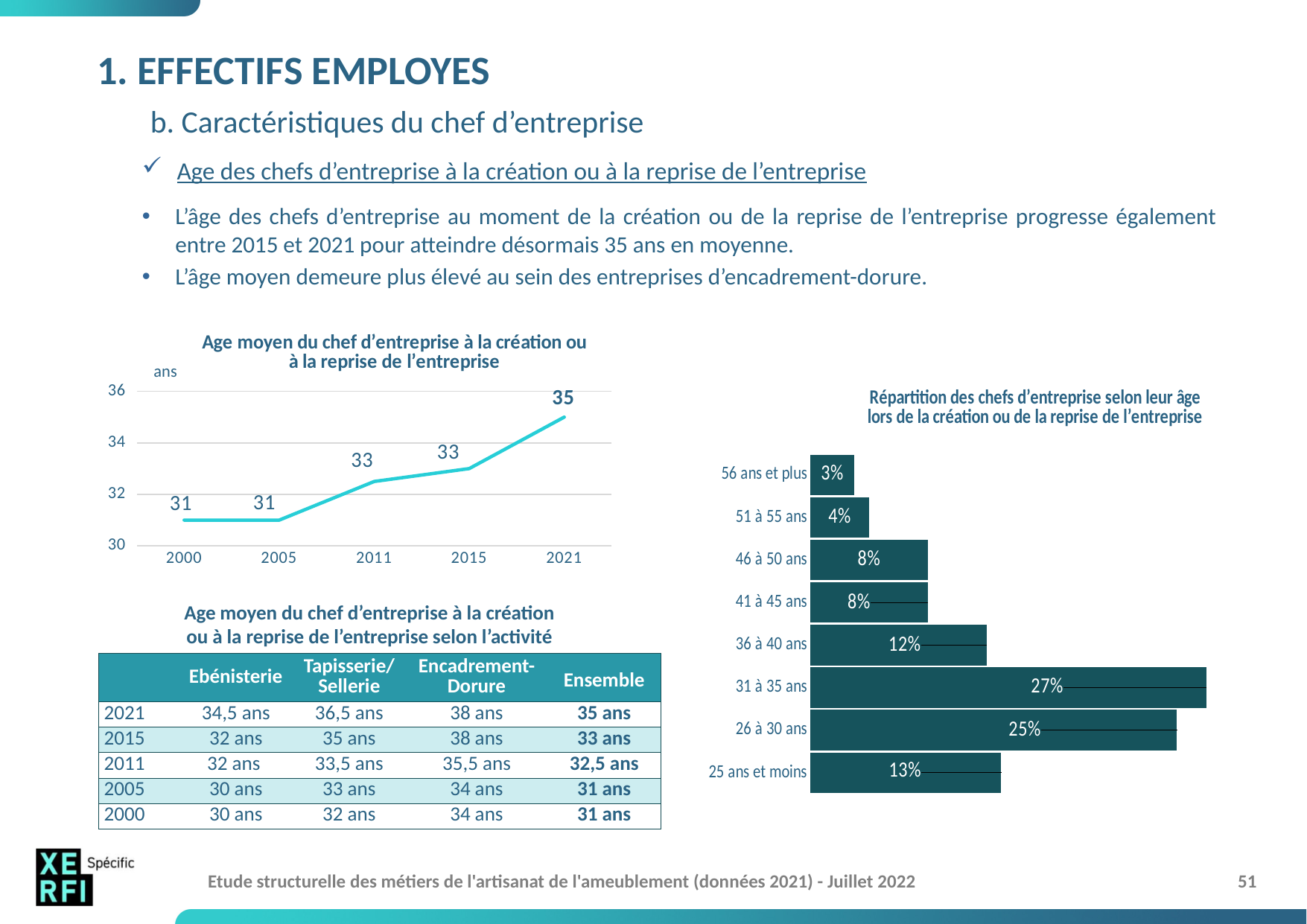
In the line chart 'Age moyen du chef d'entreprise à la création ou à la reprise de l'entreprise', which year has the highest value? 2021 In the bar chart 'Répartition des chefs d'entreprise selon leur âge', which age group has the lowest value? 56 ans et plus What type of chart is 'Répartition des chefs d'entreprise selon leur âge lors de la création ou de la reprise de l'entreprise'? bar chart In the line chart 'Age moyen du chef d'entreprise à la création ou à la reprise de l'entreprise', what is the difference between the 2021 value and the 2005 value? 4 In the bar chart 'Répartition des chefs d'entreprise selon leur âge', what is the value for '25 ans et moins'? 13% In the line chart 'Age moyen du chef d'entreprise à la création ou à la reprise de l'entreprise', do the values rise or fall from 2000 to 2021? rise In the line chart 'Age moyen du chef d'entreprise à la création ou à la reprise de l'entreprise', what is the value for 2000? 31 In the line chart 'Age moyen du chef d'entreprise à la création ou à la reprise de l'entreprise', what is the value for 2021? 35 How many data points are plotted in the line chart 'Age moyen du chef d'entreprise à la création ou à la reprise de l'entreprise'? 5 In the bar chart 'Répartition des chefs d'entreprise selon leur âge', which is larger: '26 à 30 ans' or '36 à 40 ans'? 26 à 30 ans How many age groups are shown in the bar chart 'Répartition des chefs d'entreprise selon leur âge'? 8 In the bar chart 'Répartition des chefs d'entreprise selon leur âge', what is the value for '31 à 35 ans'? 27%